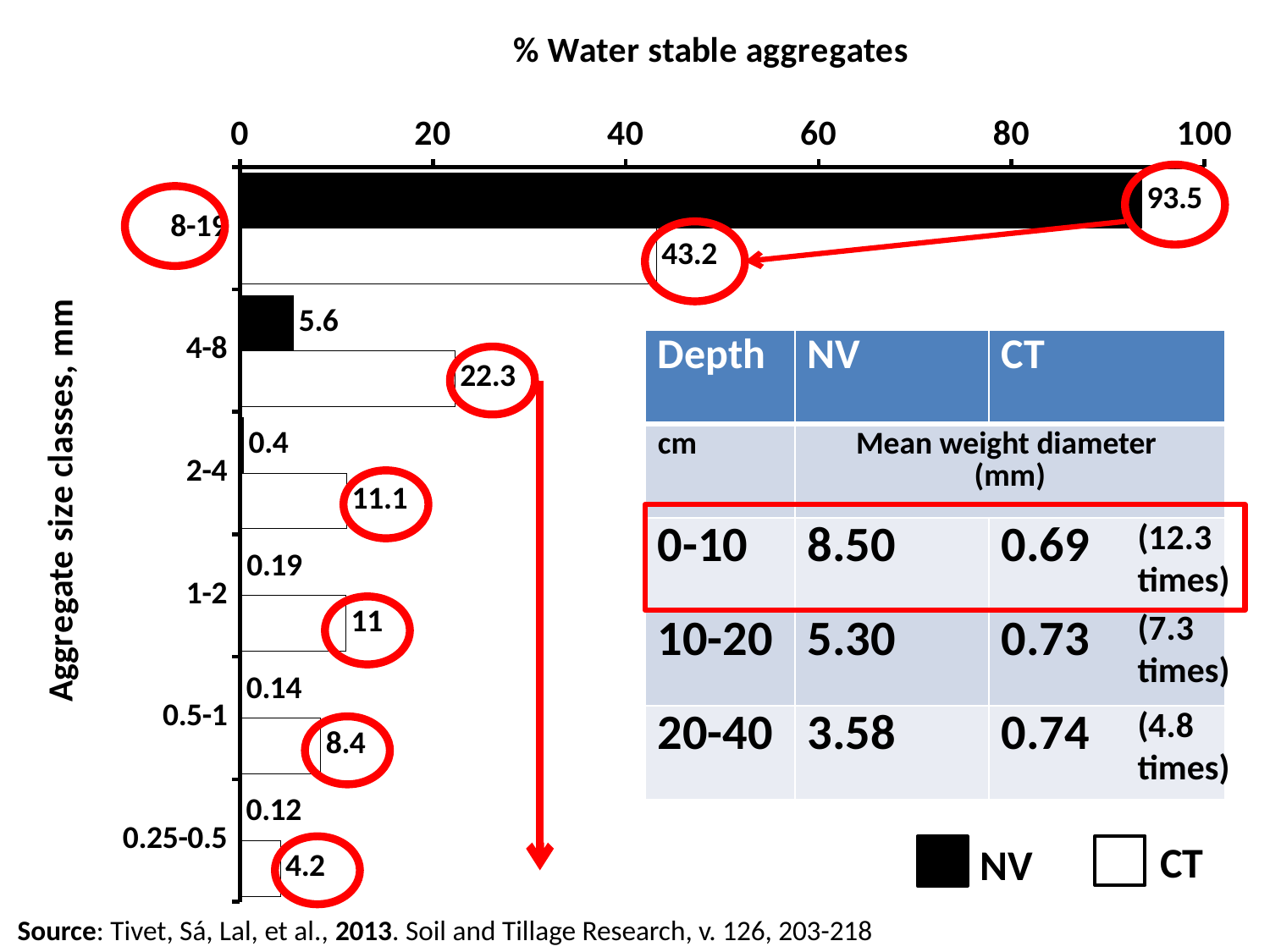
How many aggregate size classes are shown on the chart? 6 What is the NV value for the 0.25-0.5 mm aggregate size class? 0.12 What is the CT value for the 0.5-1 mm aggregate size class? 8.4 Which aggregate size class has the lowest CT value? 0.25-0.5 For the 4-8 mm aggregate size class, which series has the larger value, NV or CT? CT What is the difference between the NV and CT values for the 8-19 mm aggregate size class? 50.3 What kind of chart is shown on the slide? bar chart What is the % water stable aggregates value for NV in the 8-19 mm aggregate size class? 93.5 What is the % water stable aggregates value for CT in the 4-8 mm aggregate size class? 22.3 Which aggregate size class has the highest NV value? 8-19 How many series does the chart legend list? 2 Is the NV value for the 8-19 mm aggregate size class greater or less than 80? greater